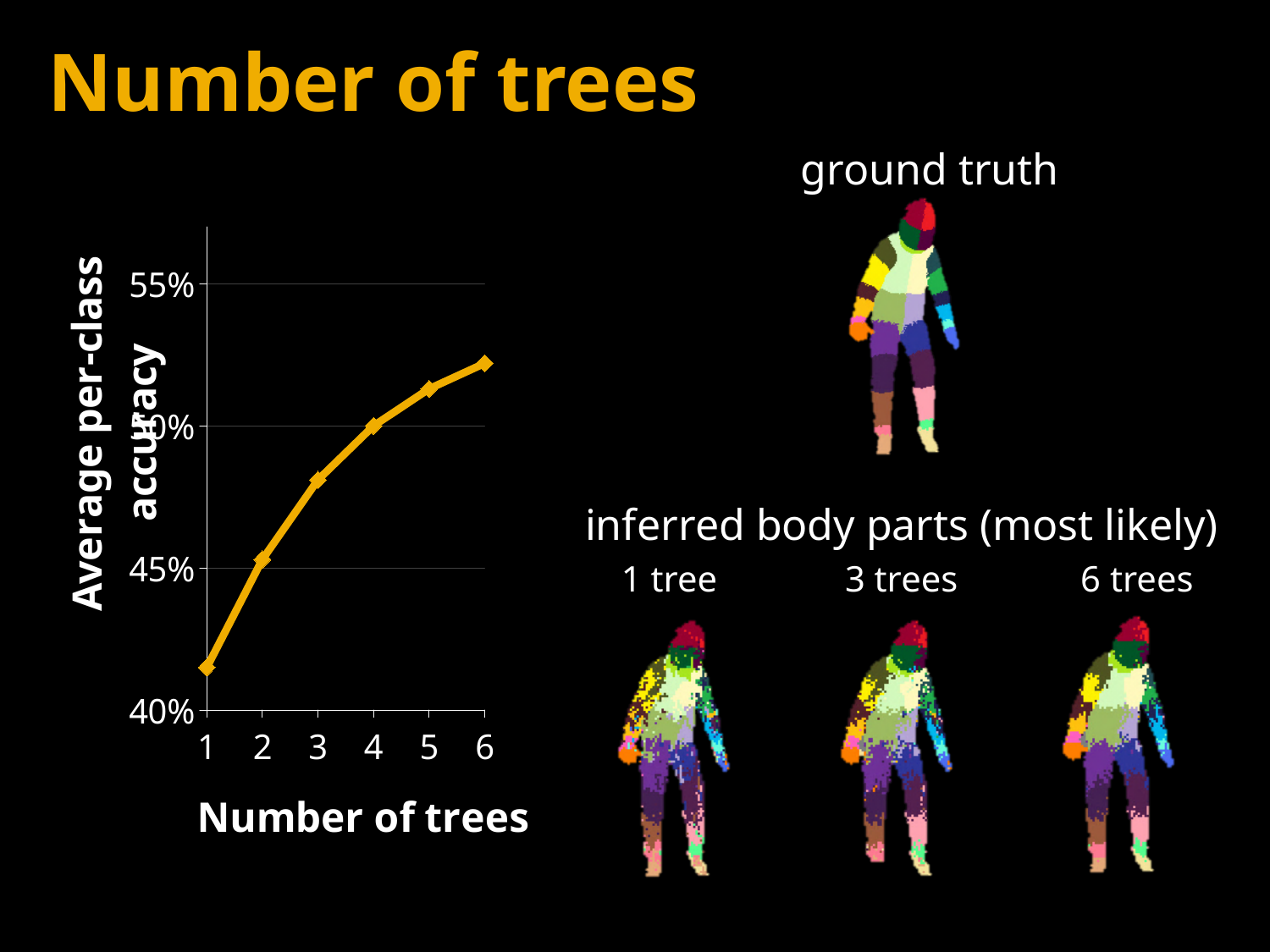
What is the title of the x axis of the chart? Number of trees What kind of chart is shown on the slide? line chart Is the average per-class accuracy for 1 tree greater or less than 45%? less Which number of trees gives the lowest average per-class accuracy? 1 How many data points are plotted on the line chart? 6 Which has the higher average per-class accuracy, 2 trees or 5 trees? 5 trees What is the title of the y axis of the chart? Average per-class accuracy Is the average per-class accuracy for 3 trees greater or less than 50%? less Which number of trees gives the highest average per-class accuracy? 6 Is the average per-class accuracy for 6 trees greater or less than 50%? greater Does the average per-class accuracy rise or fall as the number of trees increases? rise